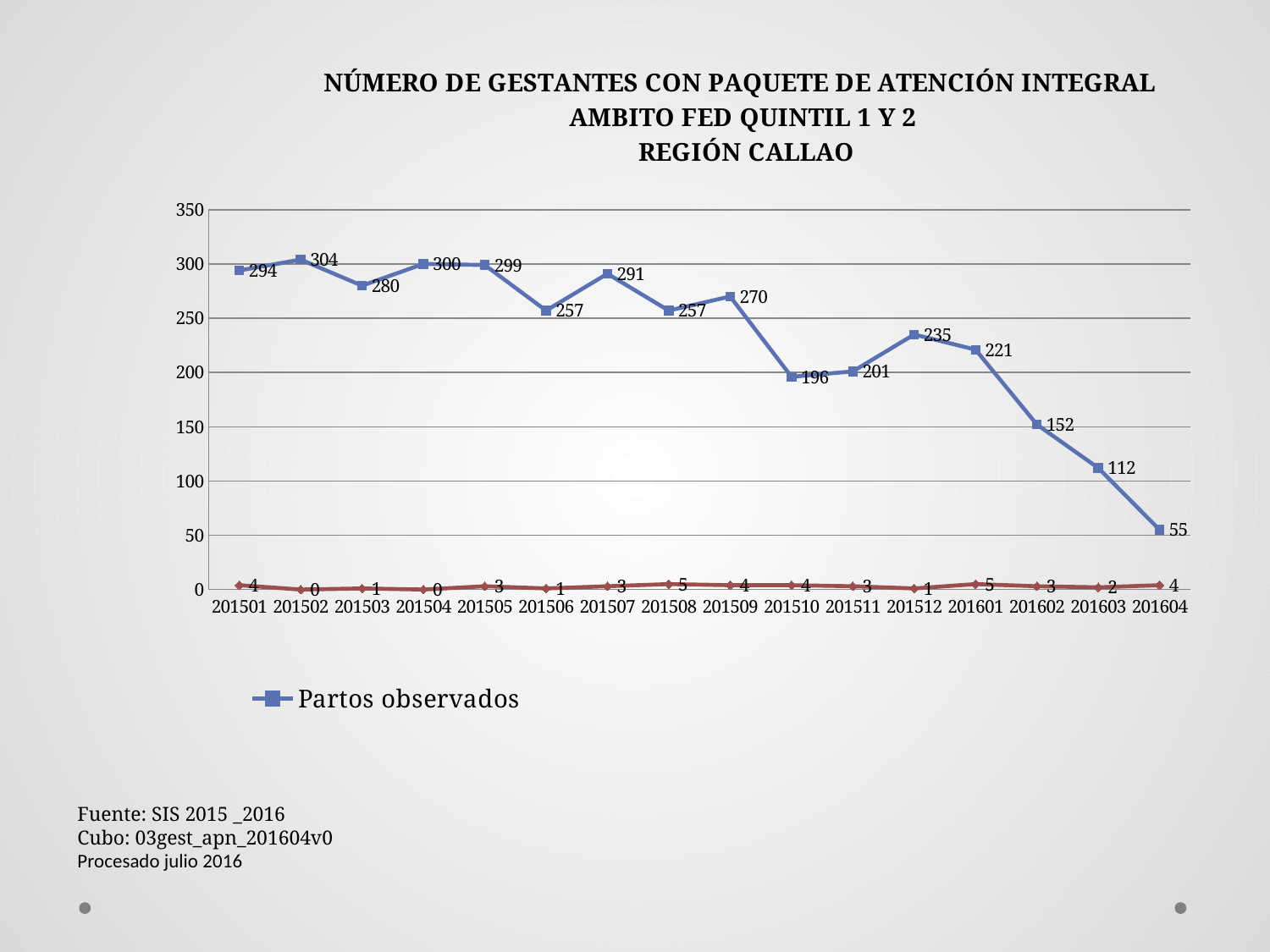
Which period has a larger value of Partos observados, 201512 or 201601? 201512 What is the value of Partos observados for 201501? 294 What is the difference between Partos observados in 201502 and in 201604? 249 What is the value of Partos observados for 201510? 196 In which period is Partos observados lowest? 201604 Does Partos observados generally rise or fall from 201501 to 201604? fall What kind of chart is shown on the slide? line chart How many periods are shown on the x axis? 16 Is the value of Partos observados for 201602 greater or less than 200? less What is the value of Partos observados for 201604? 55 How many series does the legend list? 1 In which period is Partos observados highest? 201502